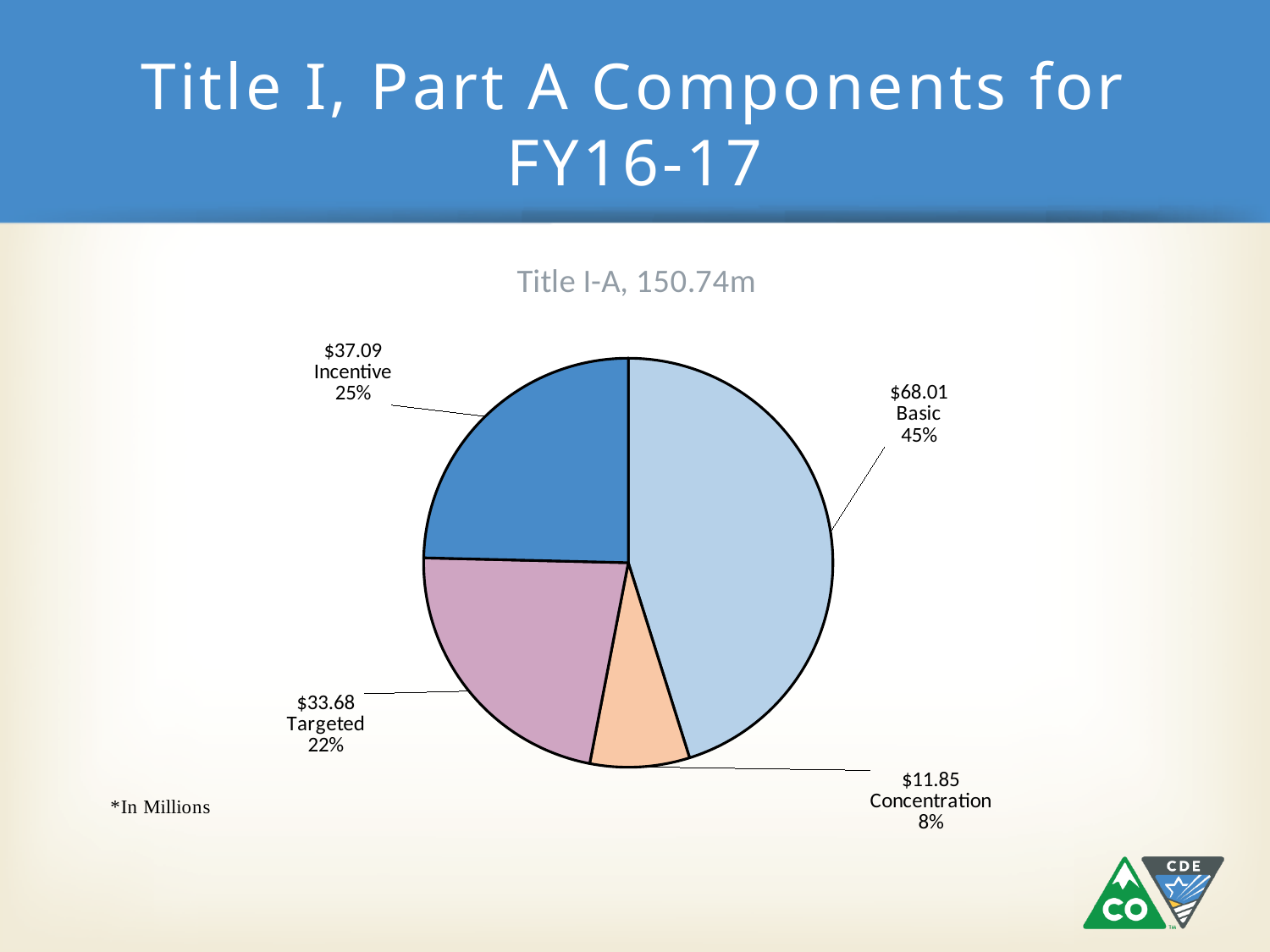
Which is larger, Incentive or Targeted? Incentive Which component is the smallest? Concentration Which component is the largest? Basic What is the difference between the values for Basic and Incentive? $30.92 What share of the pie does Targeted represent? 22% What kind of chart is shown on the slide? pie chart What is the value for Concentration? $11.85 How many slices does the pie chart have? 4 What is the value for Basic? $68.01 What is the chart's title? Title I-A, 150.74m What is the value for Incentive? $37.09 What share of the pie does Basic represent? 45%